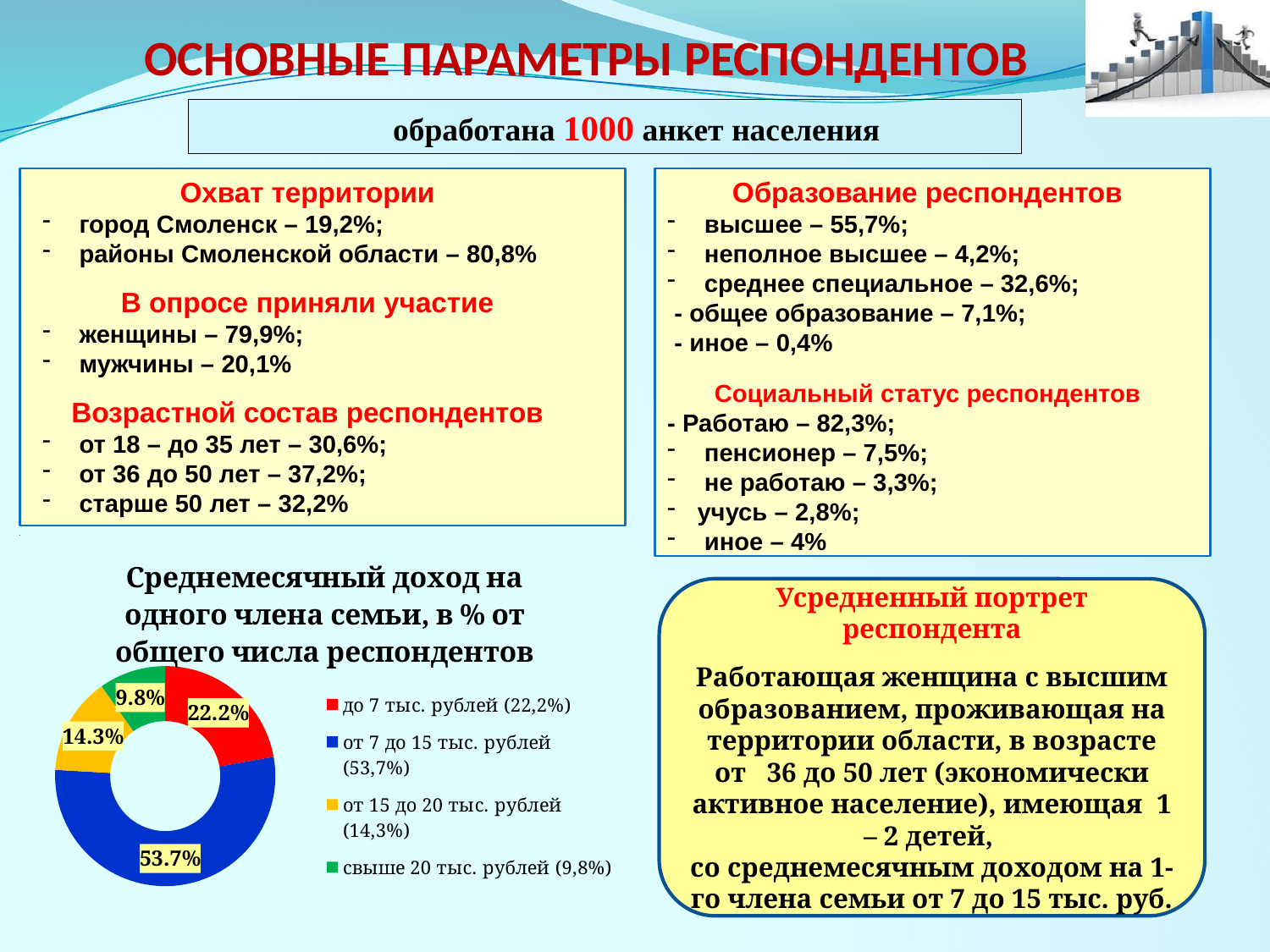
What is the difference between the shares for от 7 до 15 тыс. рублей and до 7 тыс. рублей? 31.5% How many categories does the chart show? 4 What share of respondents have an income of до 7 тыс. рублей? 22.2% What kind of chart is shown on the slide? Doughnut (pie) chart What share of respondents have an income of от 7 до 15 тыс. рублей? 53.7% Which income category has the smallest share? свыше 20 тыс. рублей What share of respondents have an income of свыше 20 тыс. рублей? 9.8% What is the title of the chart on the slide? Среднемесячный доход на одного члена семьи, в % от общего числа респондентов Which is larger: the share for до 7 тыс. рублей or for от 15 до 20 тыс. рублей? до 7 тыс. рублей What colour represents the от 7 до 15 тыс. рублей category in the chart? Blue What share of respondents have an income of от 15 до 20 тыс. рублей? 14.3% Which income category has the largest share? от 7 до 15 тыс. рублей